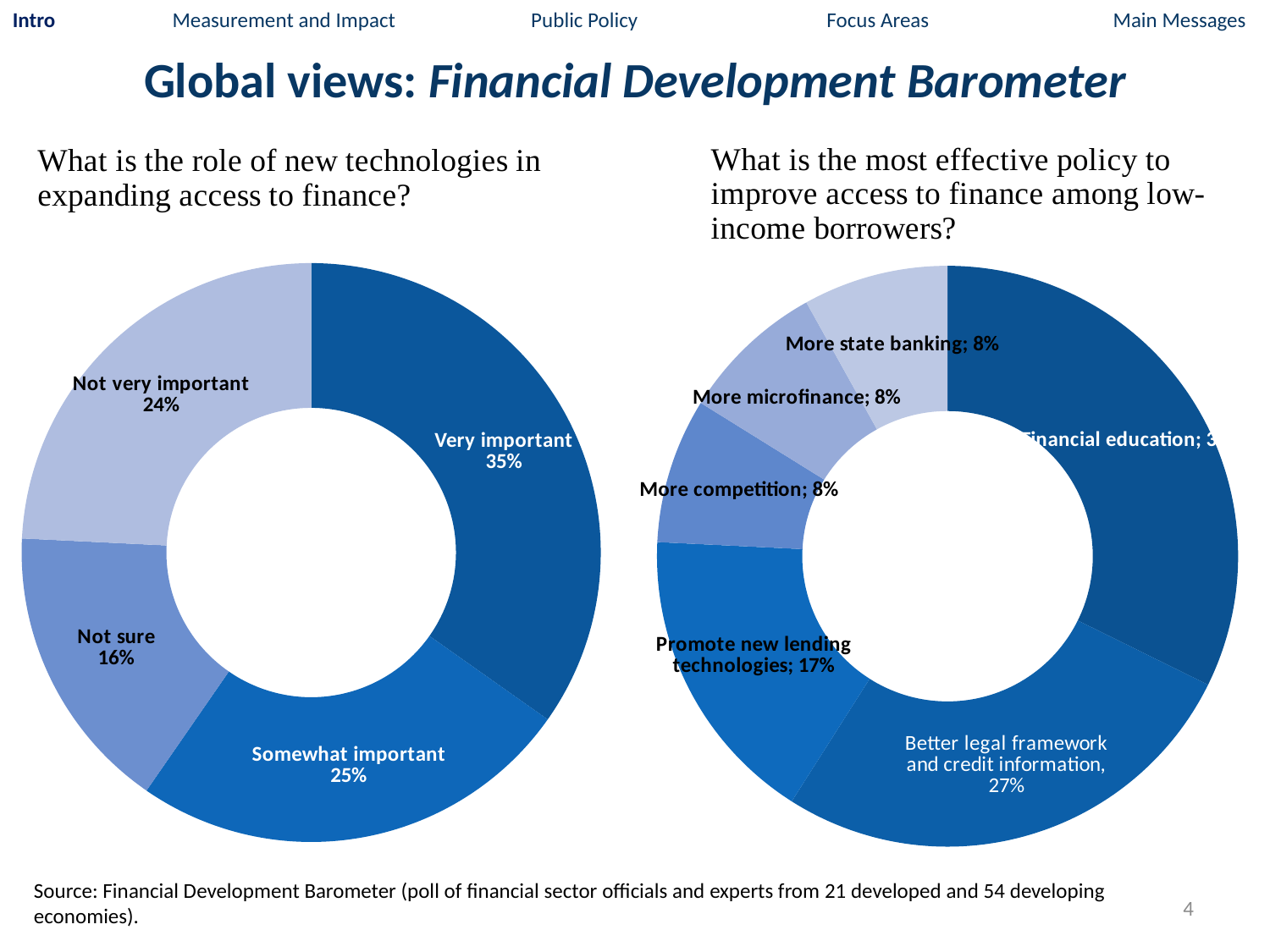
On the right chart about the most effective policy for low-income borrowers, what share chose 'Promote new lending technologies'? 17% On the left chart about the role of new technologies in expanding access to finance, what share of respondents said 'Very important'? 35% On the right chart about the most effective policy for low-income borrowers, which is larger: 'More competition' or 'Promote new lending technologies'? Promote new lending technologies On the right chart about the most effective policy for low-income borrowers, how many policy categories are shown? 6 On the right chart about the most effective policy for low-income borrowers, what share chose 'Better legal framework and credit information'? 27% On the left chart about the role of new technologies, which response has the smallest share? Not sure On the right chart about the most effective policy for low-income borrowers, which policy has the largest share? Financial education What type of chart is used on the left to show the role of new technologies? Pie (donut) chart On the left chart about the role of new technologies, what share of respondents answered 'Not sure'? 16% On the left chart about the role of new technologies, how many response categories are shown? 4 On the left chart about the role of new technologies, which response has the largest share? Very important On the left chart about the role of new technologies, how many percentage points larger is 'Very important' than 'Somewhat important'? 10 percentage points